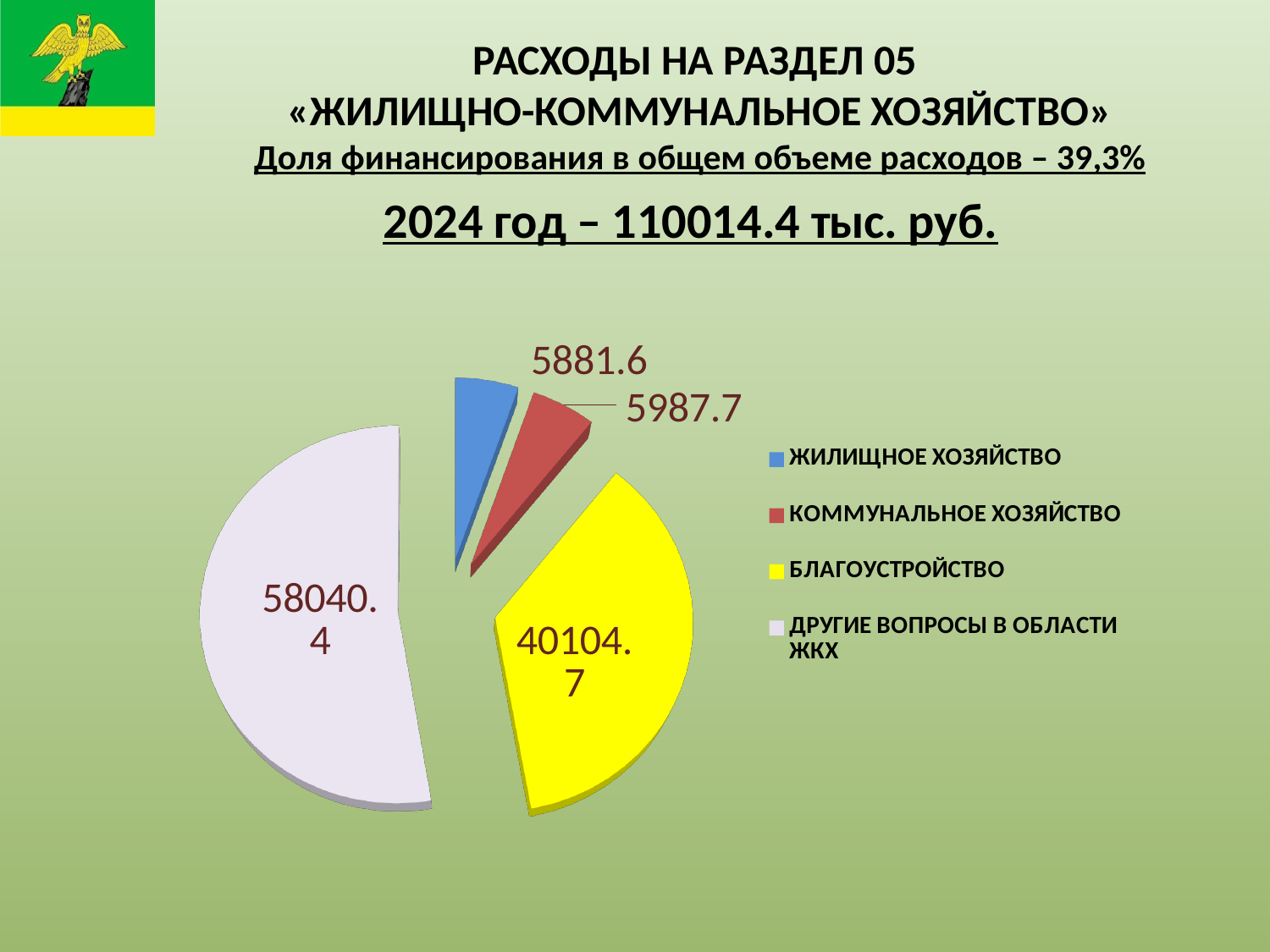
What kind of chart is shown on the slide? pie chart Which category has the smallest slice of the pie? ЖИЛИЩНОЕ ХОЗЯЙСТВО Which category has the largest slice of the pie? ДРУГИЕ ВОПРОСЫ В ОБЛАСТИ ЖКХ How many categories does the legend list? 4 What is the value for БЛАГОУСТРОЙСТВО? 40104.7 What is the difference between the values for ДРУГИЕ ВОПРОСЫ В ОБЛАСТИ ЖКХ and БЛАГОУСТРОЙСТВО? 17935.7 Which is larger, the value for БЛАГОУСТРОЙСТВО or the value for КОММУНАЛЬНОЕ ХОЗЯЙСТВО? БЛАГОУСТРОЙСТВО What is the value for КОММУНАЛЬНОЕ ХОЗЯЙСТВО? 5987.7 What is the value for ЖИЛИЩНОЕ ХОЗЯЙСТВО? 5881.6 What colour is the slice for БЛАГОУСТРОЙСТВО? yellow What is the value for ДРУГИЕ ВОПРОСЫ В ОБЛАСТИ ЖКХ? 58040.4 What is the difference between the values for КОММУНАЛЬНОЕ ХОЗЯЙСТВО and ЖИЛИЩНОЕ ХОЗЯЙСТВО? 106.1